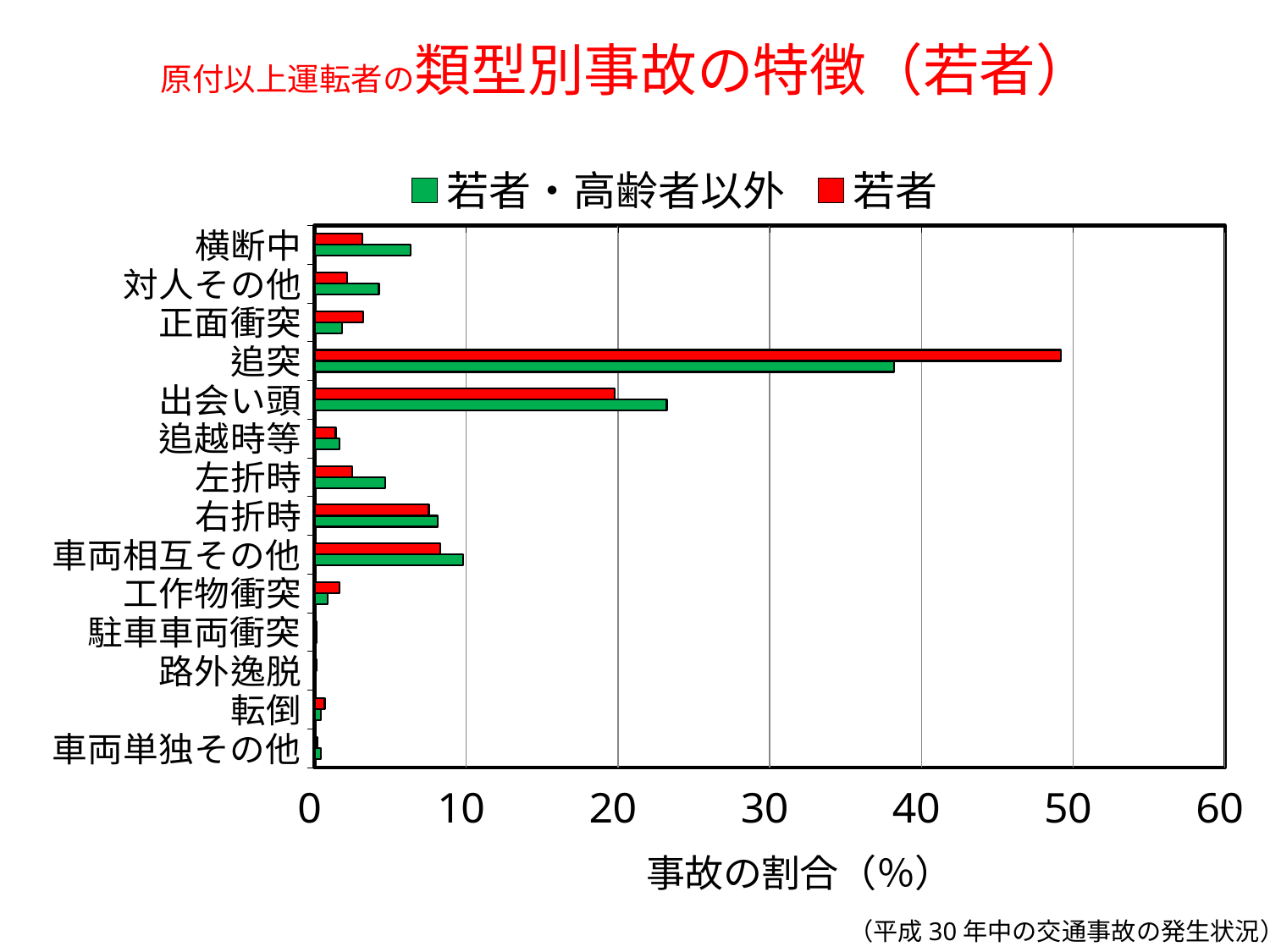
What kind of chart is shown on the slide? bar chart For 追突, which series has the larger value, 若者 or 若者・高齢者以外? 若者 Is the 若者・高齢者以外 value for 出会い頭 greater or less than 20? greater What is the label of the x axis? 事故の割合（%） Which category has the highest value for the 若者・高齢者以外 series? 追突 Is the 若者 value for 右折時 greater or less than 10? less How many accident categories are plotted on the y axis? 14 Is the 若者・高齢者以外 value for 追突 greater or less than 30? greater How many series does the legend list? 2 Which category has the highest value for the 若者 series? 追突 For 出会い頭, which series has the larger value, 若者 or 若者・高齢者以外? 若者・高齢者以外